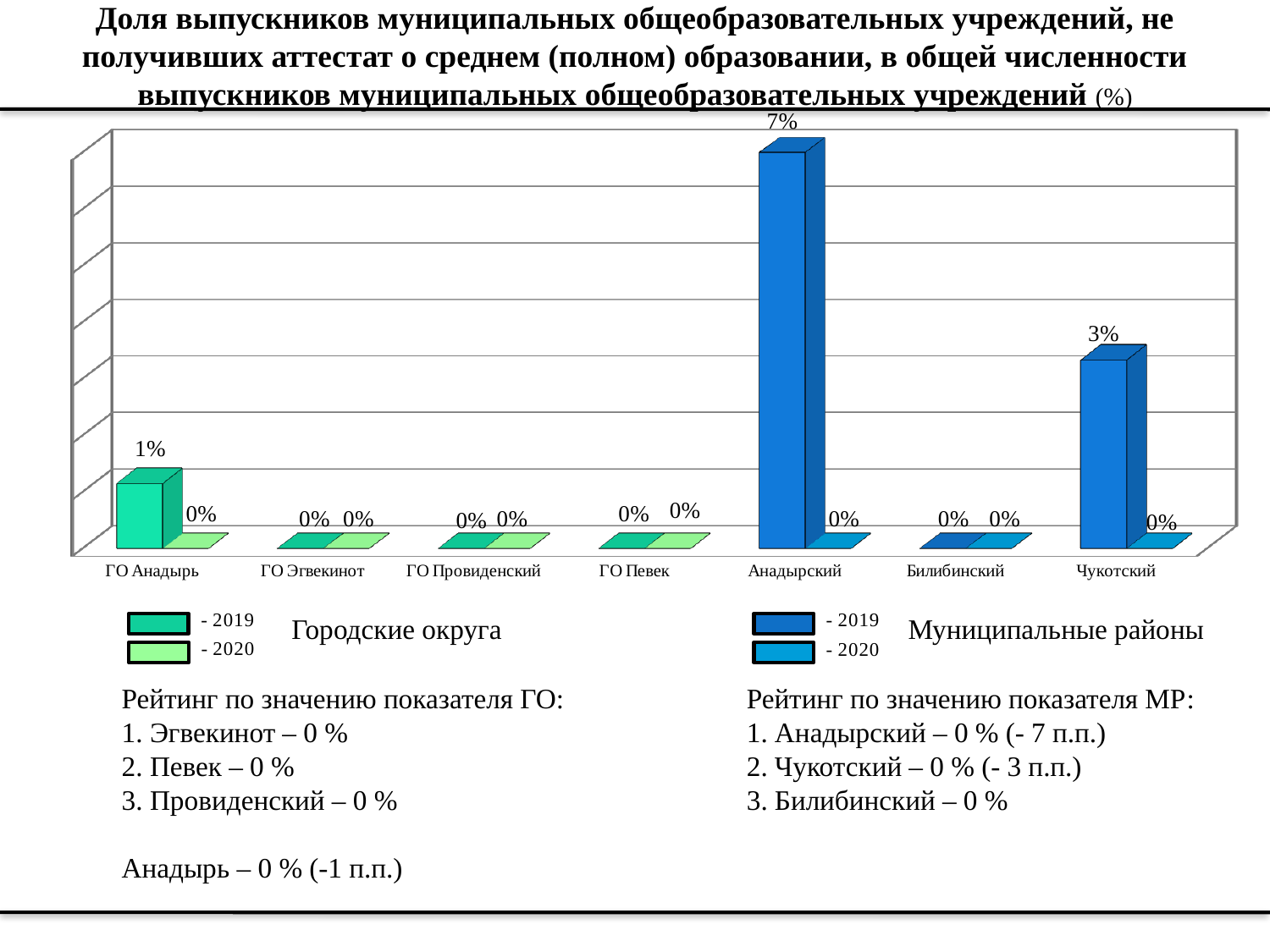
What is the 2020 value for Чукотский? 0% What is the 2019 value for ГО Анадырь? 1% What kind of chart is shown on the slide? Bar chart What is the 2019 value for Чукотский? 3% What is the difference between the 2019 values for Анадырский and Чукотский? 4% Which two years does the legend compare? 2019 and 2020 Which group of categories is labelled 'Муниципальные районы' in the legend: the green bars or the blue bars? The blue bars How many categories are shown on the x axis? 7 What is the difference between the 2019 and 2020 values for Анадырский? 7% Which category has the highest 2019 value? Анадырский What is the 2019 value for Анадырский? 7% Which is larger: the 2019 value for Чукотский or the 2019 value for ГО Анадырь? Чукотский